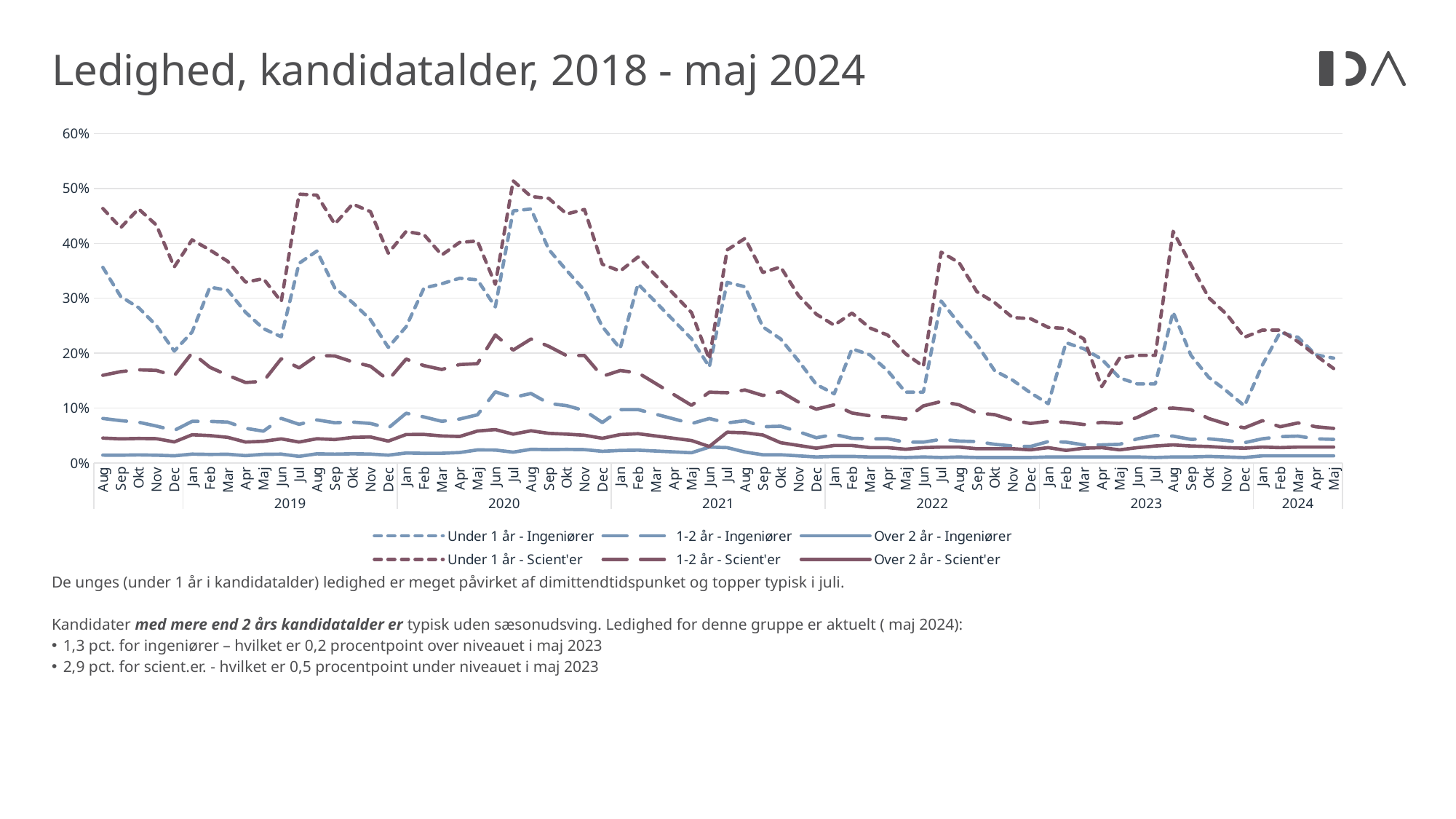
Which series reaches the highest value anywhere on the chart? Under 1 år - Scient'er What is the title of the chart? Ledighed, kandidatalder, 2018 - maj 2024 According to the text on the slide, what is the unemployment rate for ingeniører with more than 2 years since graduation in maj 2024? 1,3 pct. What colour are the Scient'er series drawn in? dark red Is the value for Under 1 år - Ingeniører in Jul 2020 greater or less than 40%? greater Is the value for Over 2 år - Scient'er in Jul 2021 greater or less than 10%? less Is the value for Under 1 år - Scient'er in Aug 2023 greater or less than 40%? greater How many series does the legend list? 6 What kind of chart is shown on the slide? line chart In Jul 2020, which is larger: Under 1 år - Scient'er or Under 1 år - Ingeniører? Under 1 år - Scient'er According to the text on the slide, what is the unemployment rate for scient.er with more than 2 years since graduation in maj 2024? 2,9 pct.